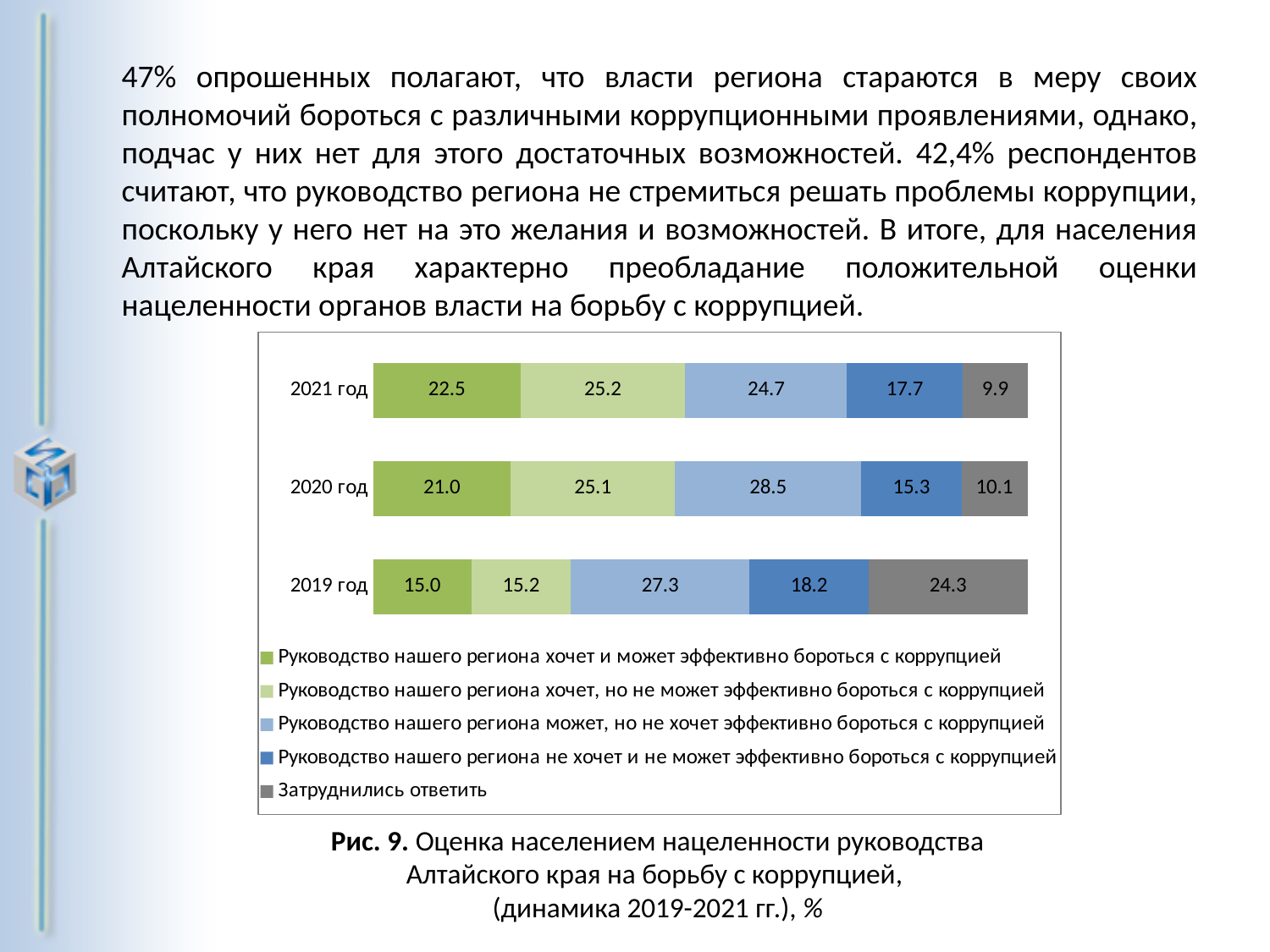
In which year is the «Затруднились ответить» segment the largest? 2019 год What is the total of the stacked bar for 2021 год? 100.0 What is the value for «Руководство нашего региона может, но не хочет эффективно бороться с коррупцией» in 2020 год? 28.5 What is the value for «Затруднились ответить» in 2019 год? 24.3 How many series does the legend list? 5 What is the value for «Руководство нашего региона хочет и может эффективно бороться с коррупцией» in 2021 год? 22.5 What is the difference between the 2021 год and 2019 год values for «Руководство нашего региона хочет, но не может эффективно бороться с коррупцией»? 10.0 What kind of chart is shown on the slide? Stacked bar chart Does the value for «Руководство нашего региона хочет и может эффективно бороться с коррупцией» rise or fall from 2019 год to 2021 год? Rises How many years (bars) are shown in the chart? 3 Which year has the larger value for «Руководство нашего региона не хочет и не может эффективно бороться с коррупцией», 2020 год or 2021 год? 2021 год In which year is the «Руководство нашего региона хочет и может эффективно бороться с коррупцией» segment the smallest? 2019 год